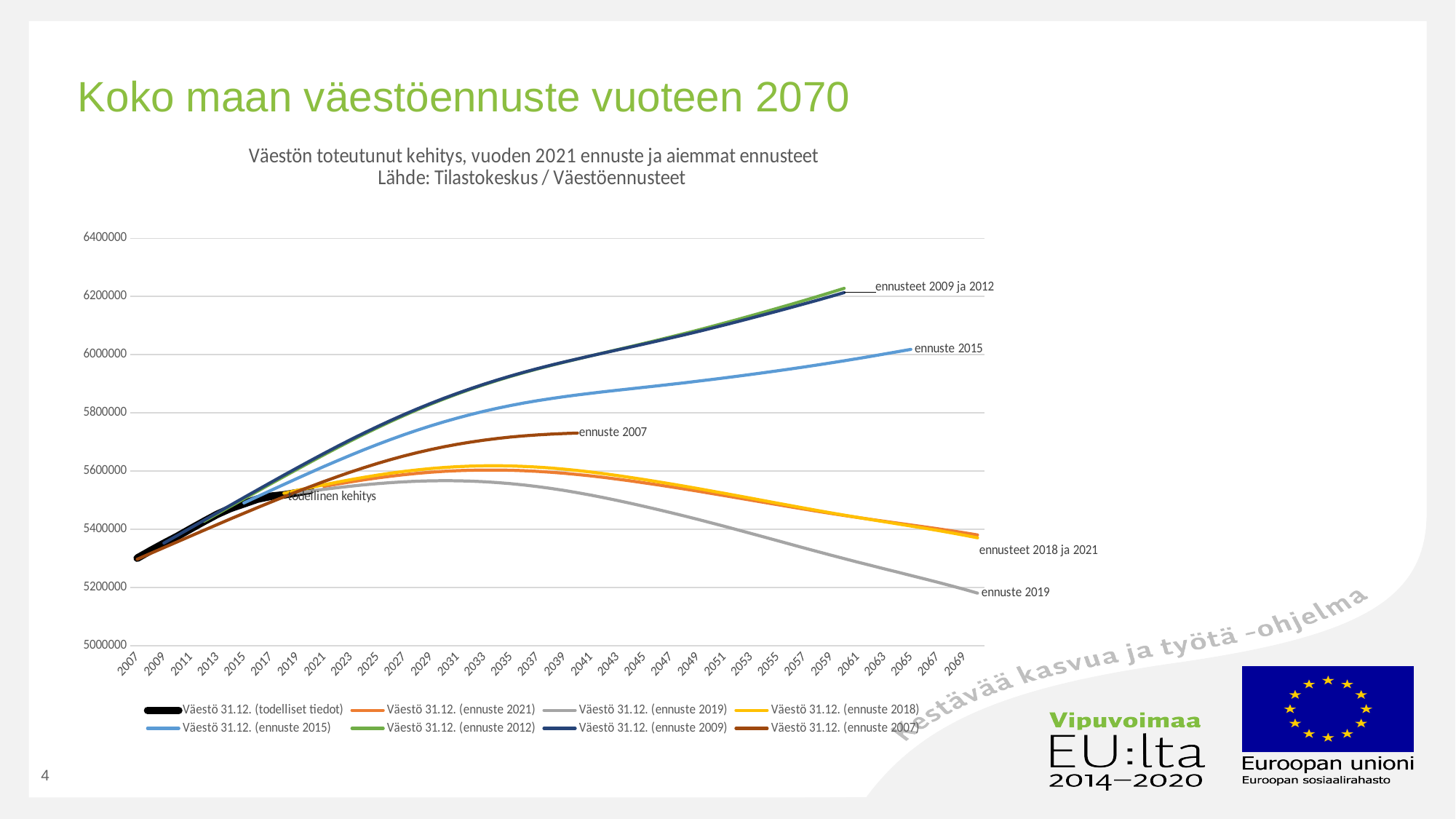
What colour is the line for Väestö 31.12. (todelliset tiedot)? black Is the population value in 2007 greater or less than 5200000? greater Are the values of the ennusteet 2009 ja 2012 lines around 2060 greater or less than 6000000? greater What is the highest value shown on the y axis? 6400000 Is the value of the ennuste 2007 line at its end point (around 2040) greater or less than 5600000? greater Does the ennuste 2015 line rise or fall from 2007 to 2065? rise In 2069, which is higher: the ennuste 2021 line or the ennuste 2019 line? ennuste 2021 How many series does the legend list? 8 Which forecast line ends at the lowest value in 2069? ennuste 2019 What is the title of the chart? Väestön toteutunut kehitys, vuoden 2021 ennuste ja aiemmat ennusteet What kind of chart is shown on the slide? line chart